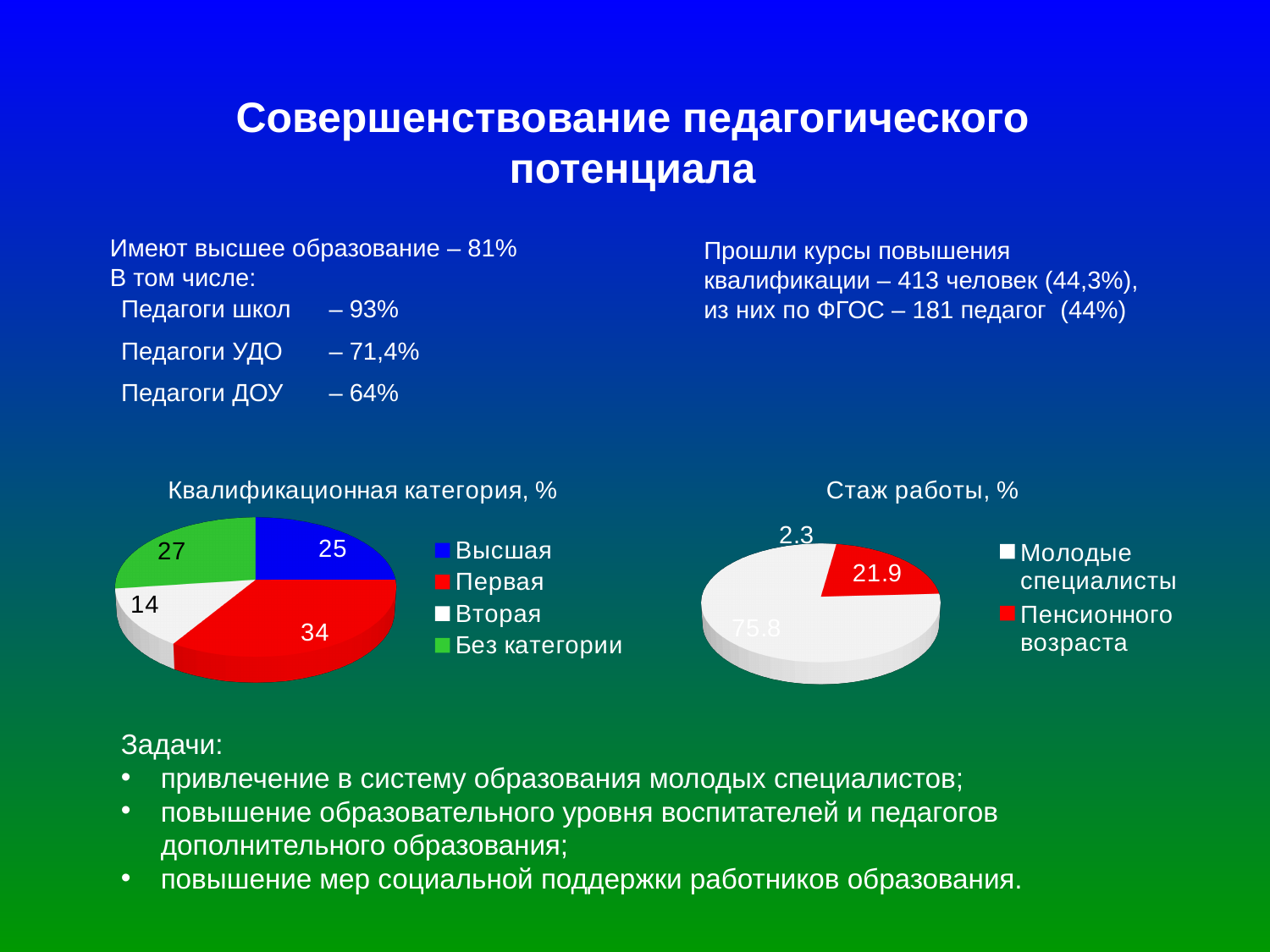
In the chart titled 'Квалификационная категория, %', which is larger: 'Без категории' or 'Высшая'? Без категории In the chart titled 'Стаж работы, %', what is the value for 'Молодые специалисты'? 2.3 In the chart titled 'Квалификационная категория, %', what is the value for 'Высшая'? 25 In the chart titled 'Квалификационная категория, %', which category has the smallest slice? Вторая How many categories does the chart titled 'Квалификационная категория, %' show? 4 How many entries does the legend of the chart titled 'Стаж работы, %' list? 2 In the chart titled 'Квалификационная категория, %', what is the value for 'Первая'? 34 In the chart titled 'Стаж работы, %', what is the difference between the values for 'Пенсионного возраста' and 'Молодые специалисты'? 19.6 In the chart titled 'Стаж работы, %', what is the value for 'Пенсионного возраста'? 21.9 In the chart titled 'Квалификационная категория, %', which category has the largest slice? Первая In the chart titled 'Квалификационная категория, %', what is the difference between the values for 'Первая' and 'Высшая'? 9 What kind of chart is the one titled 'Квалификационная категория, %'? Pie chart